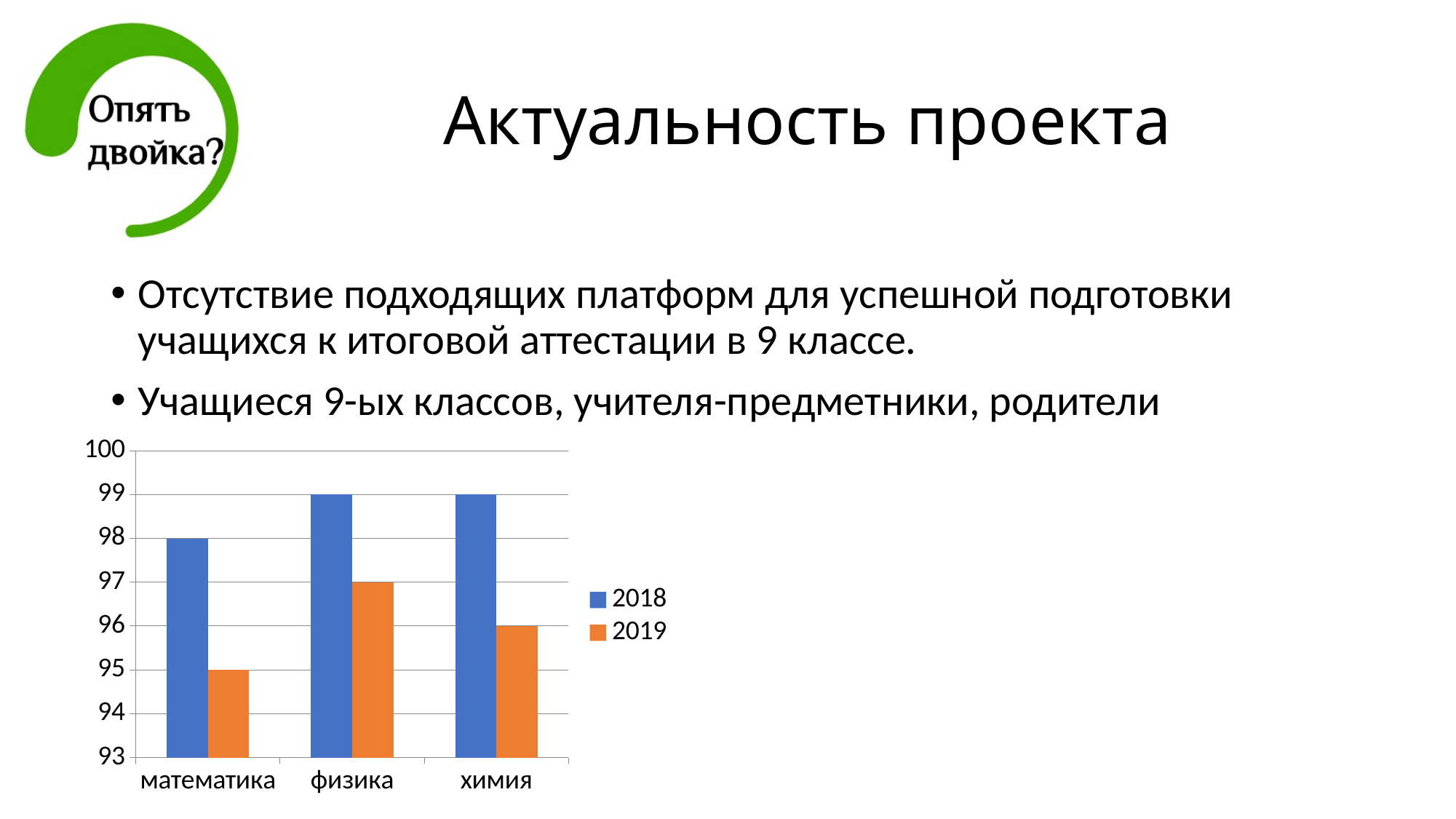
What is the value for химия in the 2019 series? 96 Which is larger for химия, the 2018 value or the 2019 value? 2018 Which category has the lowest value in the 2019 series? математика What kind of chart is shown on the slide? bar chart What is the value for математика in the 2018 series? 98 What is the value for физика in the 2019 series? 97 Which colour represents the 2019 series in the legend? orange Is the 2019 value for математика greater or less than 96? less Which category has the highest value in the 2019 series? физика How many series does the legend list? 2 What is the difference between the 2018 and 2019 values for математика? 3 How many categories are shown on the x axis? 3